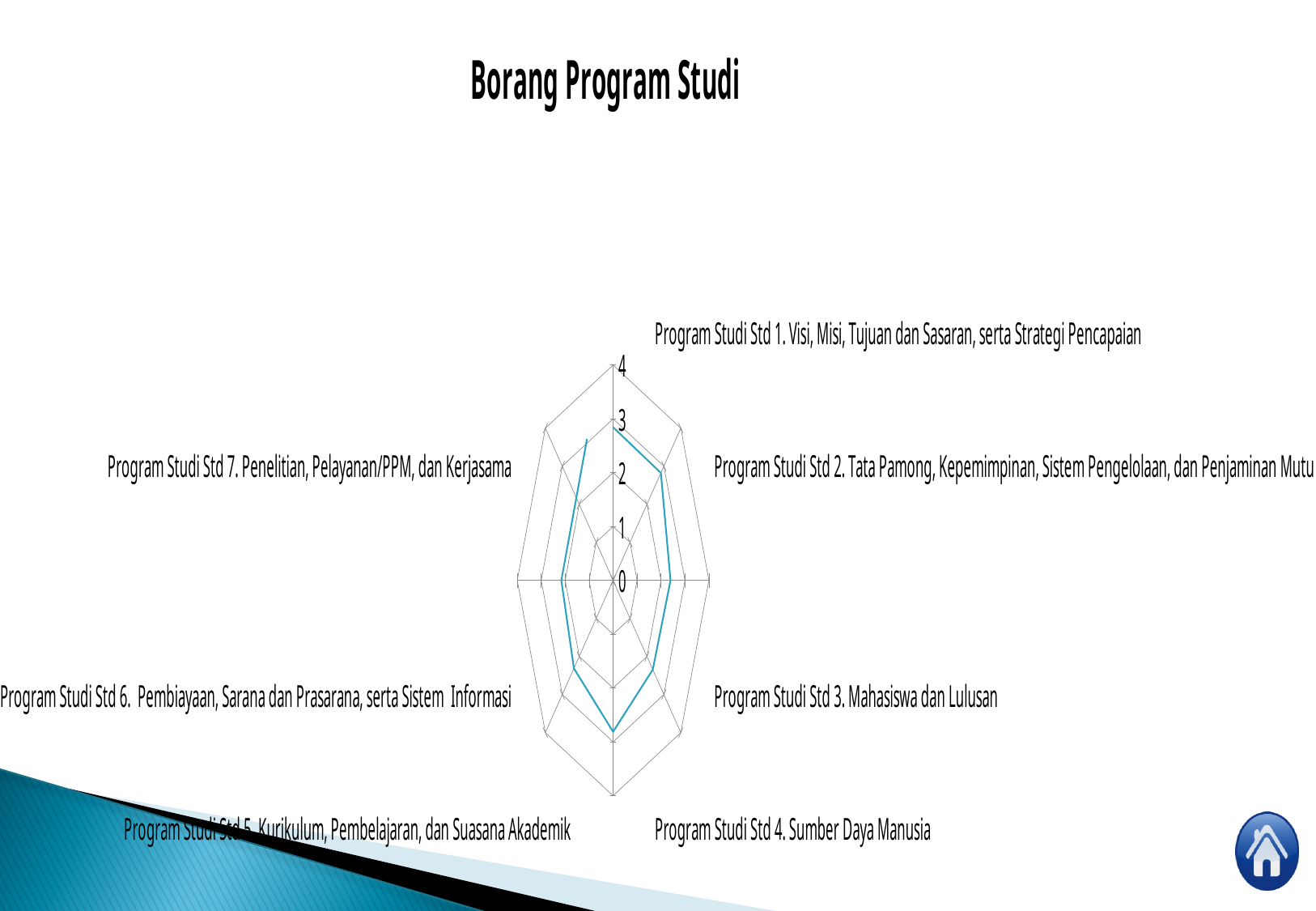
Is the value for Program Studi Std 7. Penelitian, Pelayanan/PPM, dan Kerjasama greater or less than 4? less Is the value for Program Studi Std 5. Kurikulum, Pembelajaran, dan Suasana Akademik greater or less than 1? greater How many categories (axes) does the radar chart have? 7 What is the title of the chart on the slide? Borang Program Studi Is the value for Program Studi Std 6. Pembiayaan, Sarana dan Prasarana, serta Sistem Informasi greater or less than 1? greater What kind of chart is shown on the slide? Radar chart What is the highest value shown on the chart's axis scale? 4